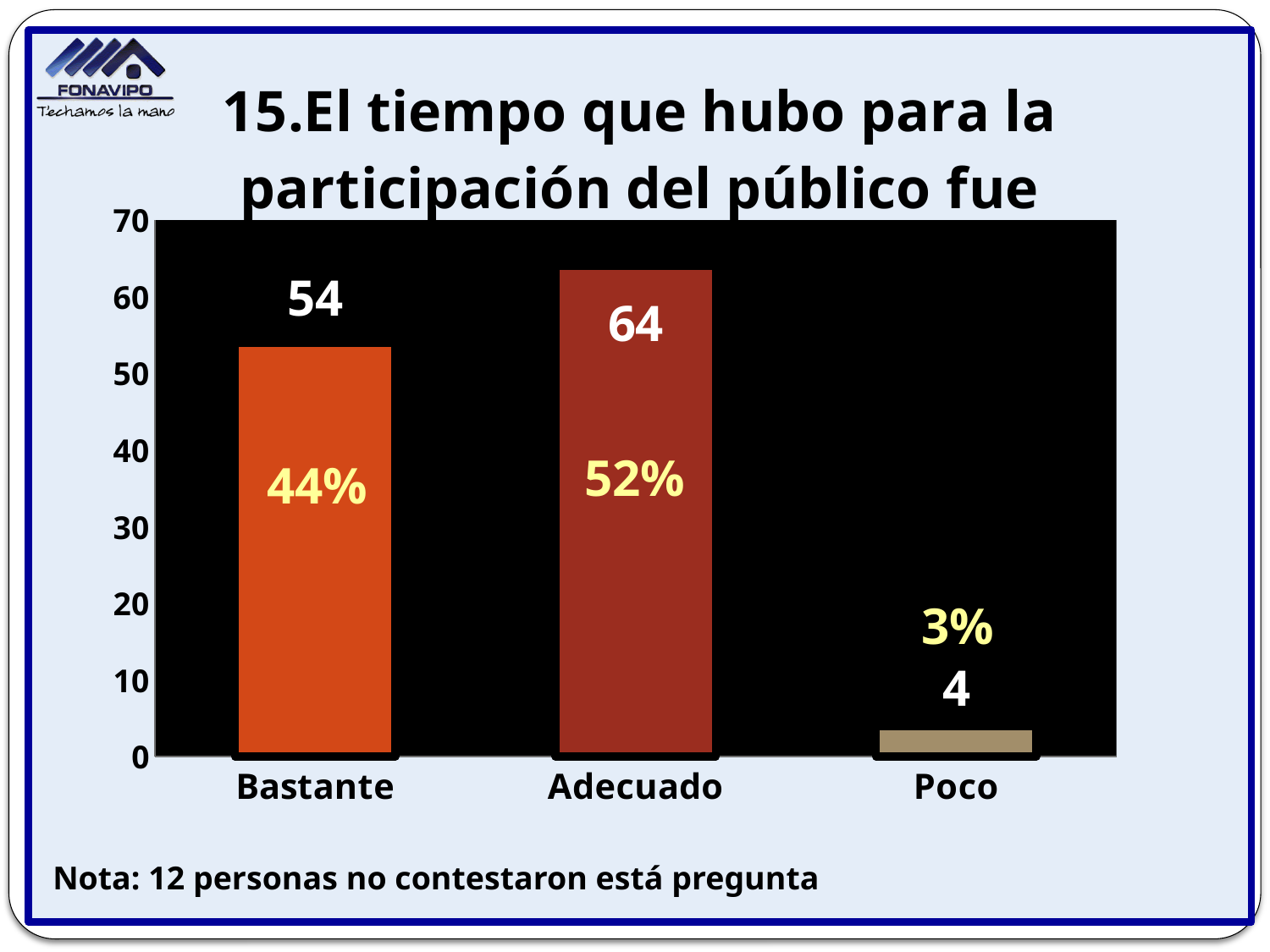
What percentage is shown for Bastante? 44% Which category has the highest value? Adecuado What kind of chart is this? bar chart What is the value for Adecuado? 64 What is the value for Poco? 4 Which category has the lowest value? Poco What is the difference between the values for Adecuado and Bastante? 10 How many categories are shown on the x axis? 3 What percentage is shown for Poco? 3% What is the value for Bastante? 54 Which is larger, the value for Bastante or the value for Poco? Bastante According to the note, how many people did not answer this question? 12